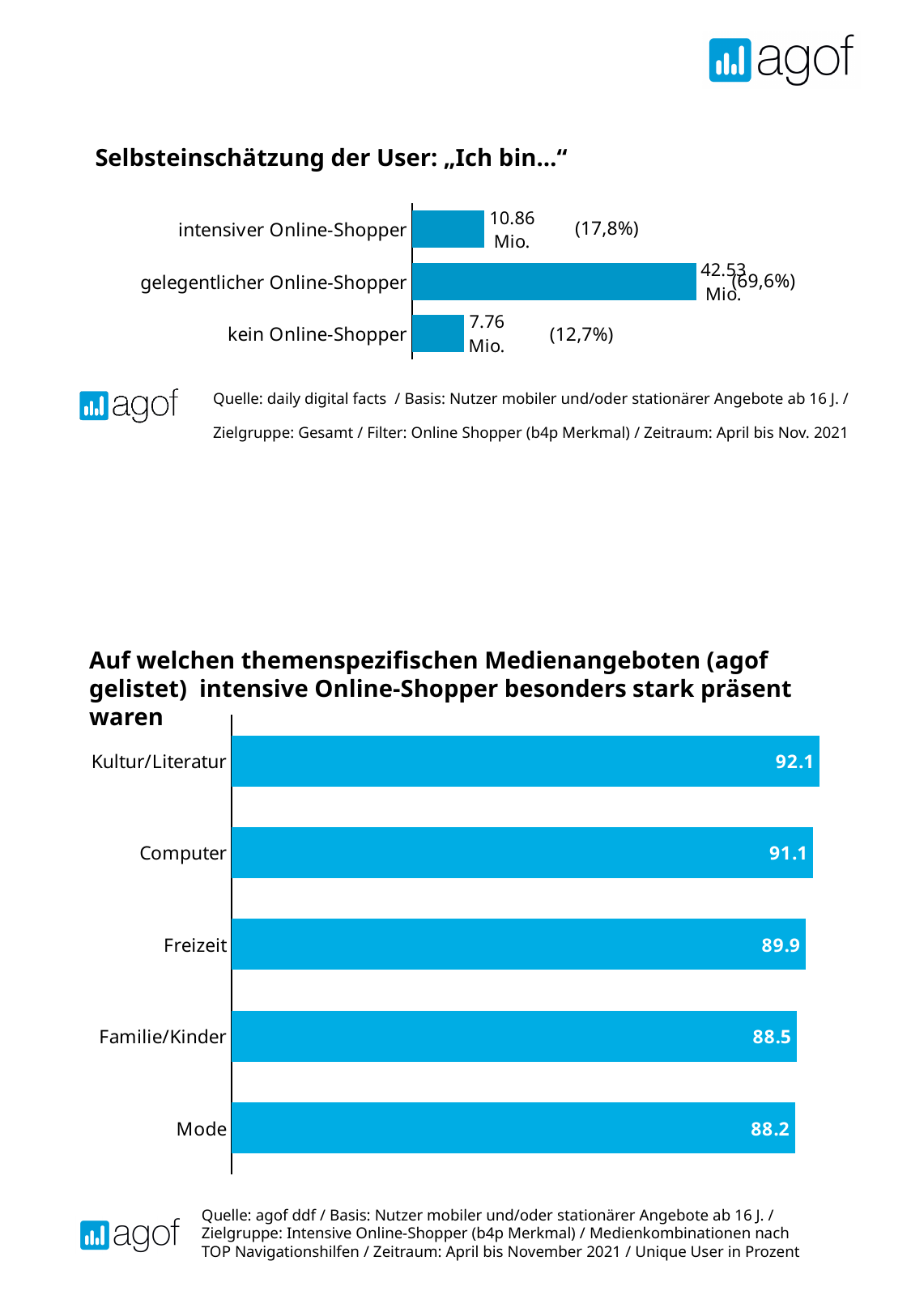
In the top chart "Selbsteinschätzung der User", what value is shown for "intensiver Online-Shopper"? 10.86 Mio. In the bottom chart about themenspezifische Medienangebote, how many categories are shown? 5 In the top chart "Selbsteinschätzung der User", what percentage is shown for "kein Online-Shopper"? 12,7% In the bottom chart about themenspezifische Medienangebote, what is the difference between the values for "Kultur/Literatur" and "Computer"? 1.0 In the bottom chart about themenspezifische Medienangebote, what value is shown for "Freizeit"? 89.9 In the bottom chart about themenspezifische Medienangebote, what value is shown for "Mode"? 88.2 What type of chart is the bottom chart about themenspezifische Medienangebote? bar chart In the bottom chart about themenspezifische Medienangebote, which category has the highest value? Kultur/Literatur In the top chart "Selbsteinschätzung der User", which category has the lowest value? kein Online-Shopper In the top chart "Selbsteinschätzung der User", how many categories are shown? 3 In the top chart "Selbsteinschätzung der User", what value is shown for "gelegentlicher Online-Shopper"? 42.53 Mio. In the top chart "Selbsteinschätzung der User", which category has the highest value? gelegentlicher Online-Shopper